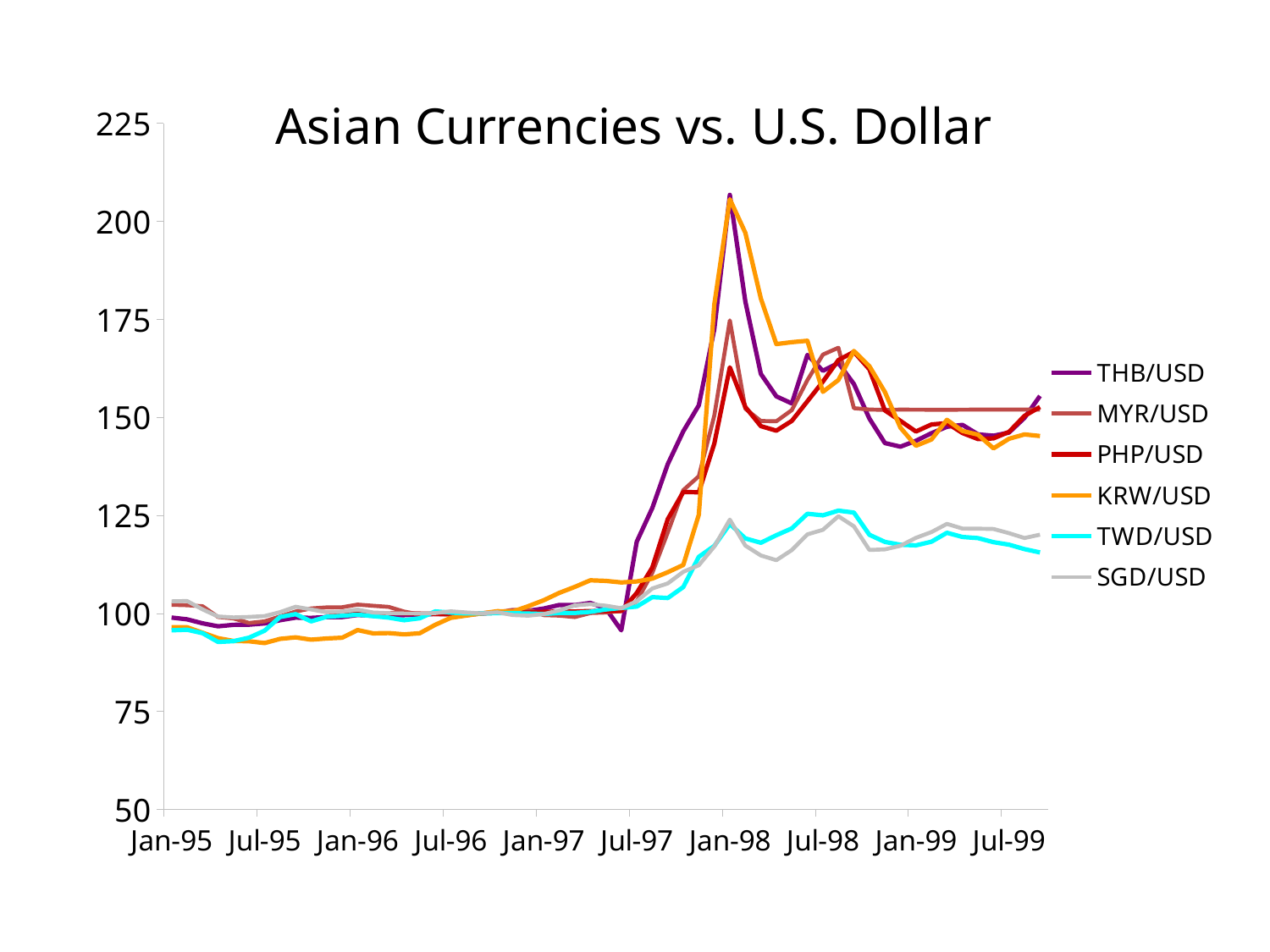
Around Jan-98, which series has the larger value, THB/USD or TWD/USD? THB/USD Is the peak value of THB/USD around Jan-98 greater or less than 200? greater How many series does the legend list? 6 Which series is drawn in cyan (light blue)? TWD/USD What kind of chart is shown on the slide? line chart What is the title of the chart? Asian Currencies vs. U.S. Dollar Is the value for TWD/USD at Jul-99 greater or less than 125? less Does the THB/USD line rise or fall between Jul-97 and Jan-98? rise How many date labels are shown on the x axis? 10 Is the value for PHP/USD around Jan-98 greater or less than 150? greater Does the TWD/USD line rise or fall between Jul-98 and Jul-99? fall